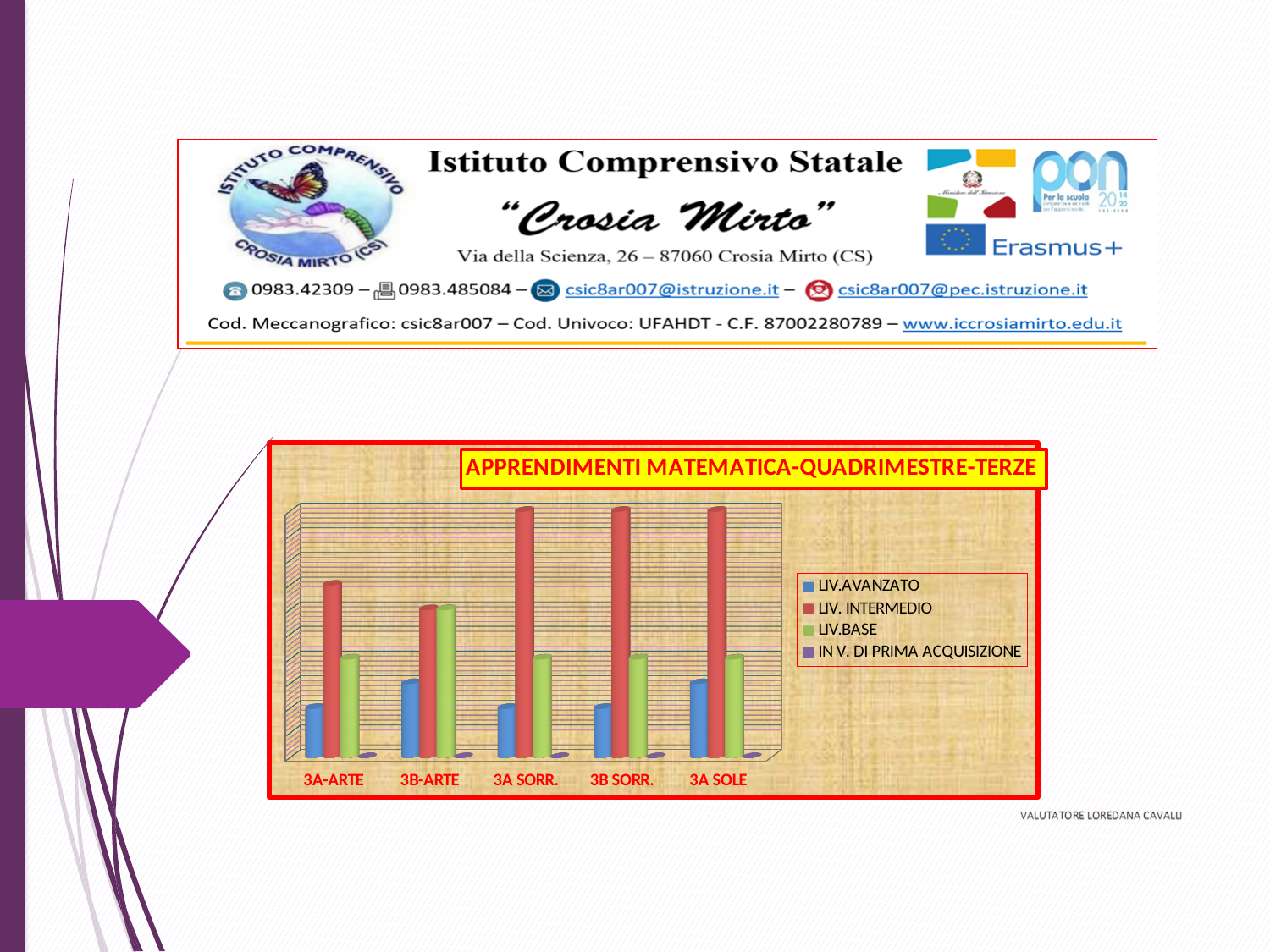
Which series has the highest bar for 3A-ARTE? LIV. INTERMEDIO Which class has the larger LIV. INTERMEDIO bar: 3A-ARTE or 3B-ARTE? 3A-ARTE Which series is shown in red in the chart? LIV. INTERMEDIO What is the title of the chart? APPRENDIMENTI MATEMATICA-QUADRIMESTRE-TERZE How many series does the chart's legend list? 4 For 3A-ARTE, which is larger: LIV. INTERMEDIO or LIV.BASE? LIV. INTERMEDIO How many classes (categories) are shown along the x axis of the chart? 5 What kind of chart is shown on the slide? bar chart Which class has the lowest LIV. INTERMEDIO bar? 3B-ARTE Which class has the highest LIV.BASE bar? 3B-ARTE Which series has the lowest bar in every class? IN V. DI PRIMA ACQUISIZIONE For 3A SOLE, which is larger: LIV.AVANZATO or LIV.BASE? LIV.BASE